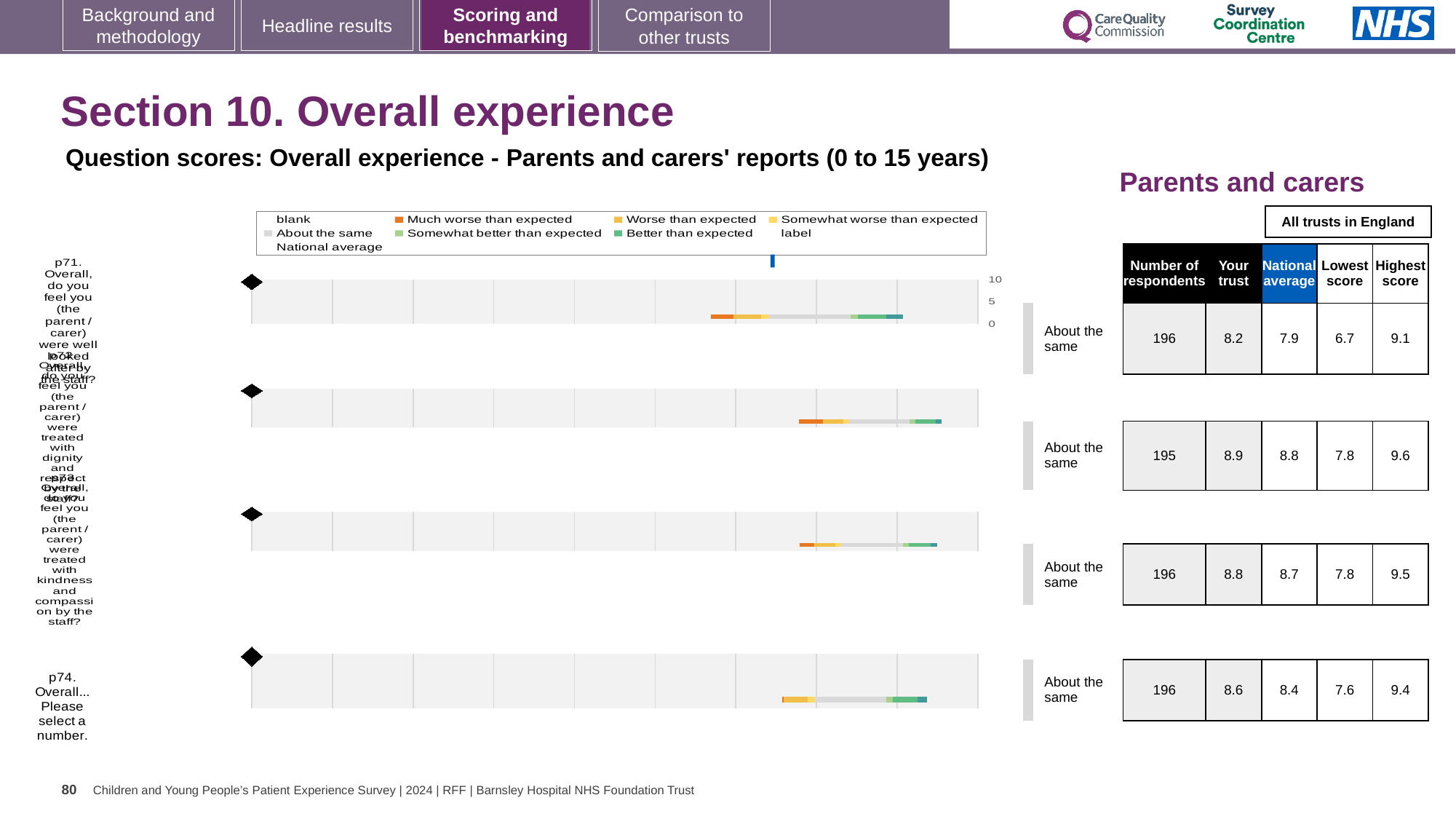
How many respondents are listed for the second row of the table? 195 How many entries does the chart legend list? 9 Which row has the highest 'Your trust' score? the second row (8.9) What is the National average for the first row (p71)? 7.9 What is the difference between the 'Your trust' score and the National average for the first row (p71)? 0.3 What is the 'Your trust' score for the last row (p74, Overall... Please select a number)? 8.6 For the last row (p74), is the 'Your trust' score or the National average larger? Your trust (8.6) What is the 'Your trust' score for the first row (p71, Overall, do you feel you were well looked after by the staff)? 8.2 How many question rows (bars) are plotted in the chart? 4 What kind of chart is shown on the left of the slide? bar chart Which row has the lowest 'Your trust' score? the first row, p71 (8.2) What is the Highest score shown for the second row of the table? 9.6